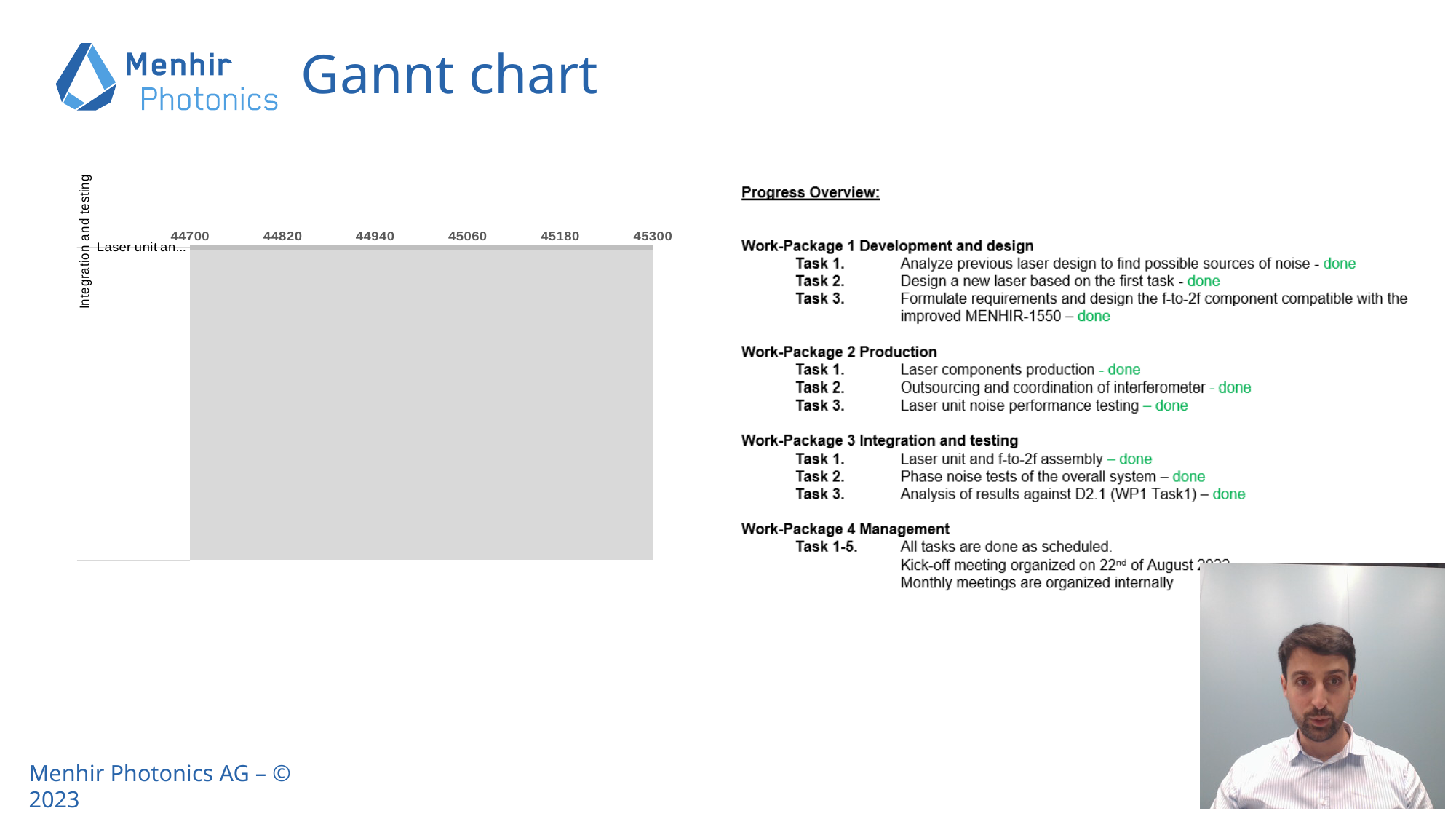
How many tick labels are printed along the chart's horizontal axis? 6 What is the highest tick value shown on the chart's horizontal axis? 45300 What is the lowest tick value shown on the chart's horizontal axis? 44700 What kind of chart is shown on the left of the slide? bar chart How many category labels are visible on the chart's vertical axis? 1 What is the label written along the chart's vertical axis? Integration and testing What is the interval between consecutive tick labels on the chart's horizontal axis? 120